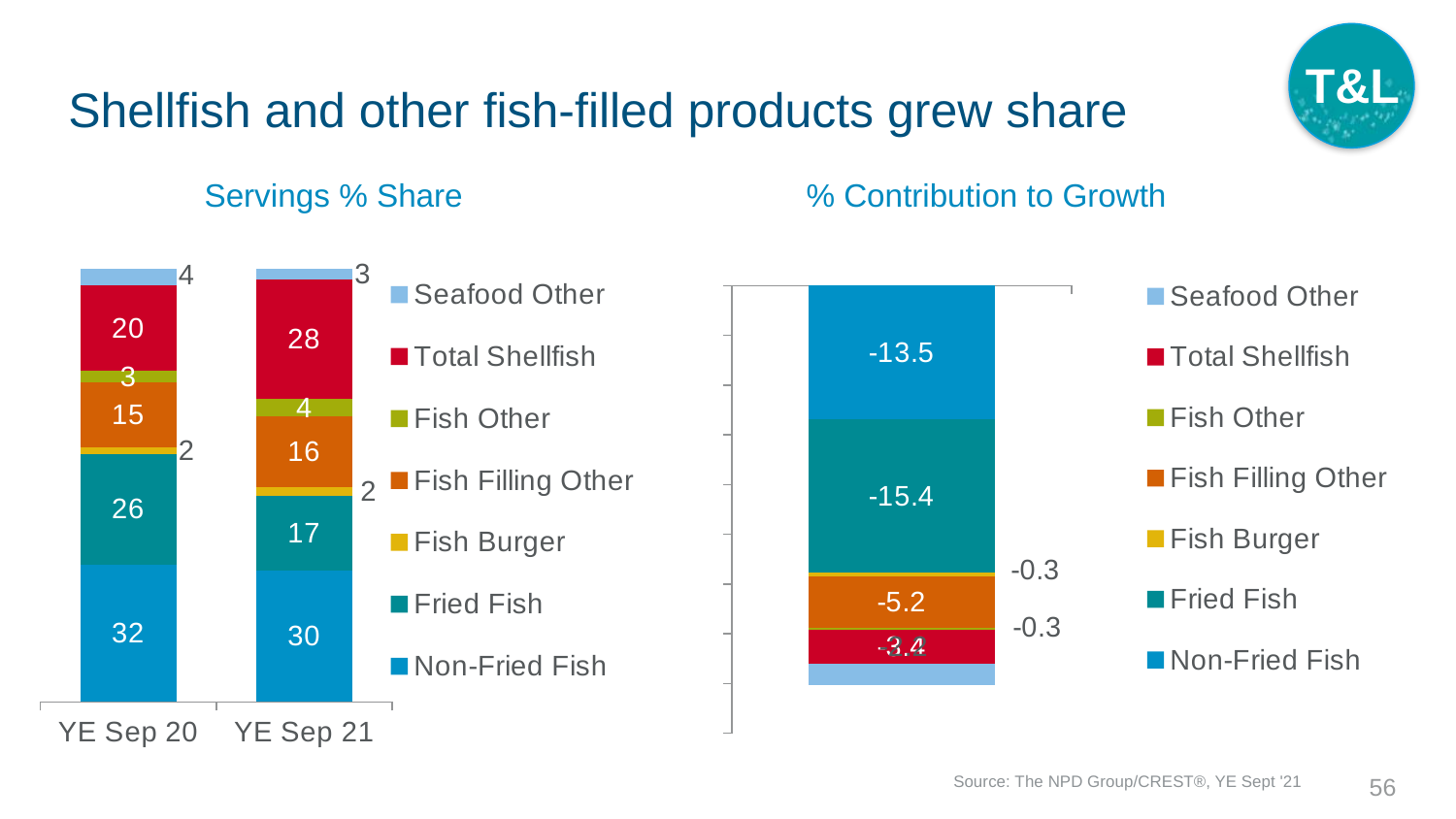
In the Servings % Share chart, what is the value for Non-Fried Fish in YE Sep 20? 32 How many series does the legend of the Servings % Share chart list? 7 What kind of chart is the Servings % Share chart? Stacked bar chart In the % Contribution to Growth chart, what is the value for Non-Fried Fish? -13.5 In the Servings % Share chart, what is the value for Total Shellfish in YE Sep 21? 28 In the Servings % Share chart, what is the value for Fried Fish in YE Sep 21? 17 In the Servings % Share chart, is the Fish Filling Other value higher in YE Sep 20 or YE Sep 21? YE Sep 21 In the Servings % Share chart, by how much did the Total Shellfish share change from YE Sep 20 to YE Sep 21? 8 How many bars (time periods) are shown in the Servings % Share chart? 2 In the Servings % Share chart, which segment is the largest in the YE Sep 20 bar? Non-Fried Fish In the Servings % Share chart, what is the difference between the Fried Fish values for YE Sep 20 and YE Sep 21? 9 In the % Contribution to Growth chart, what is the value for Fried Fish? -15.4